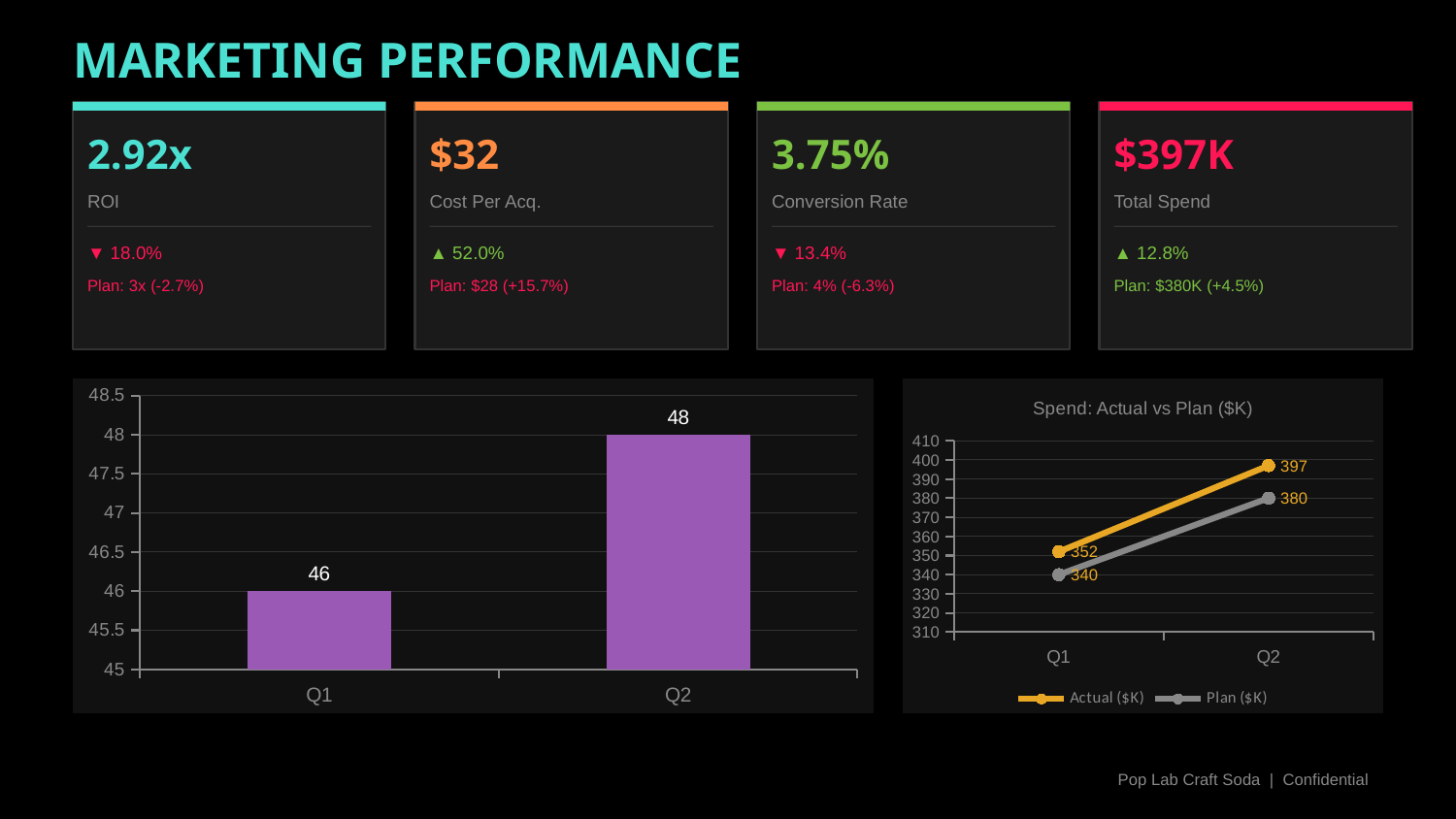
In the 'Spend: Actual vs Plan ($K)' chart, does the Actual ($K) series rise or fall from Q1 to Q2? Rise In the bar chart on the left of the slide, what is the value for Q2? 48 In the bar chart on the left of the slide, which quarter has the higher value? Q2 What kind of chart is the chart on the left of the slide? Bar chart In the 'Spend: Actual vs Plan ($K)' chart, what is the difference between Actual ($K) and Plan ($K) in Q2? 17 In the bar chart on the left of the slide, what is the value for Q1? 46 In the 'Spend: Actual vs Plan ($K)' chart, which series is larger in Q1, Actual ($K) or Plan ($K)? Actual ($K) In the 'Spend: Actual vs Plan ($K)' chart, what is the Plan ($K) value for Q1? 340 In the 'Spend: Actual vs Plan ($K)' chart, how many series does the legend list? 2 In the bar chart on the left of the slide, what is the difference between the Q2 and Q1 values? 2 In the 'Spend: Actual vs Plan ($K)' chart, what is the Actual ($K) value for Q2? 397 In the bar chart on the left of the slide, how many categories are shown on the x axis? 2